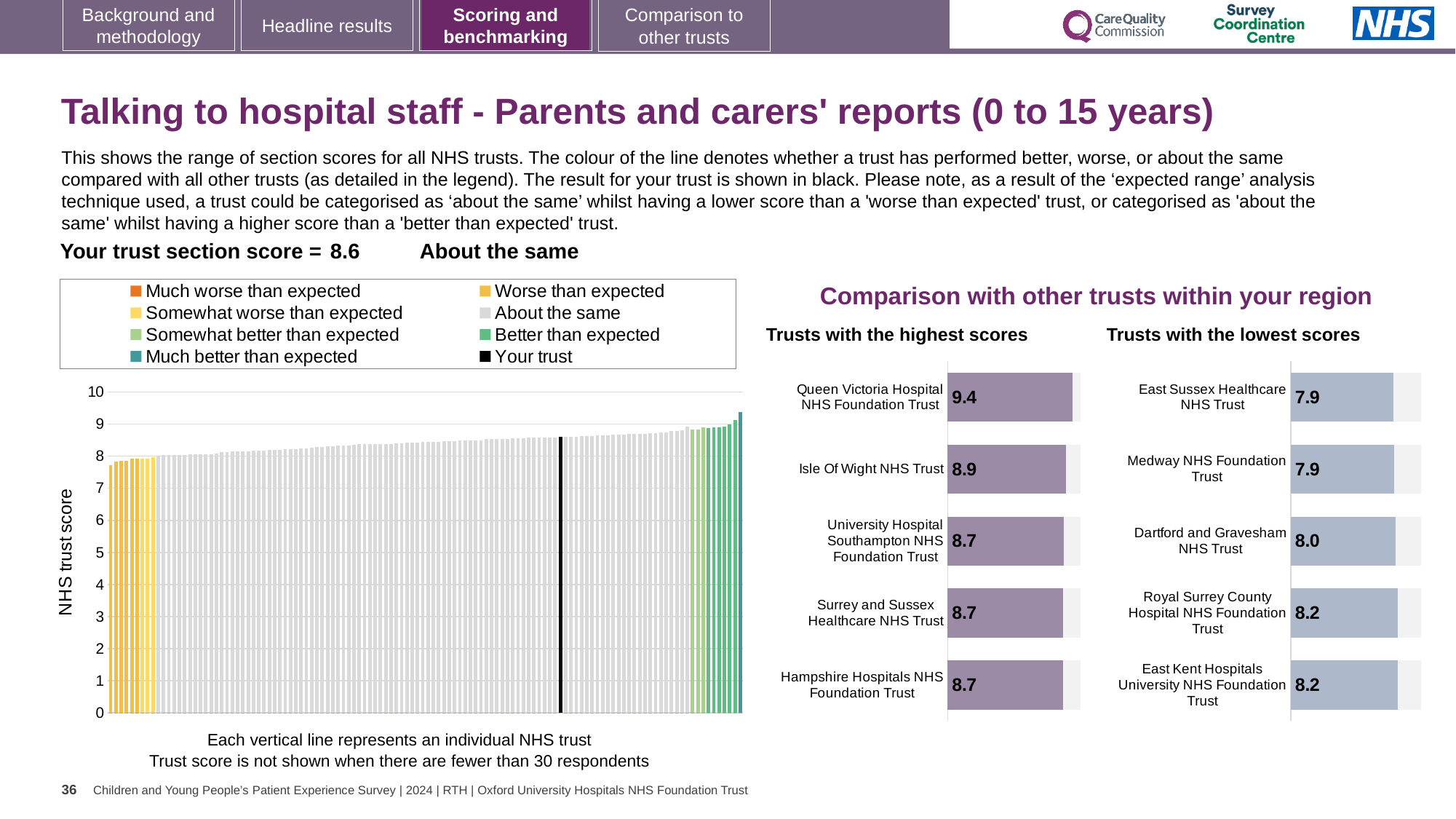
In the 'Trusts with the highest scores' chart, what is the score for Isle Of Wight NHS Trust? 8.9 In the NHS trust score chart on the left, is the value for the black 'Your trust' bar greater or less than 8? greater In the NHS trust score chart on the left, do the bar heights rise or fall from left to right? rise How many trusts are shown in the 'Trusts with the lowest scores' chart? 5 How many entries does the legend above the NHS trust score chart list? 8 In the 'Trusts with the lowest scores' chart, what is the difference between the scores of Royal Surrey County Hospital NHS Foundation Trust and East Sussex Healthcare NHS Trust? 0.3 In the 'Trusts with the lowest scores' chart, what is the score for Dartford and Gravesham NHS Trust? 8.0 In the 'Trusts with the lowest scores' chart, what is the score for East Kent Hospitals University NHS Foundation Trust? 8.2 In the 'Trusts with the lowest scores' chart, which has the larger score: Dartford and Gravesham NHS Trust or Royal Surrey County Hospital NHS Foundation Trust? Royal Surrey County Hospital NHS Foundation Trust In the 'Trusts with the highest scores' chart, what is the difference between the scores of Queen Victoria Hospital NHS Foundation Trust and Isle Of Wight NHS Trust? 0.5 In the 'Trusts with the highest scores' chart, what is the score for Queen Victoria Hospital NHS Foundation Trust? 9.4 In the 'Trusts with the highest scores' chart, which trust has the highest score? Queen Victoria Hospital NHS Foundation Trust